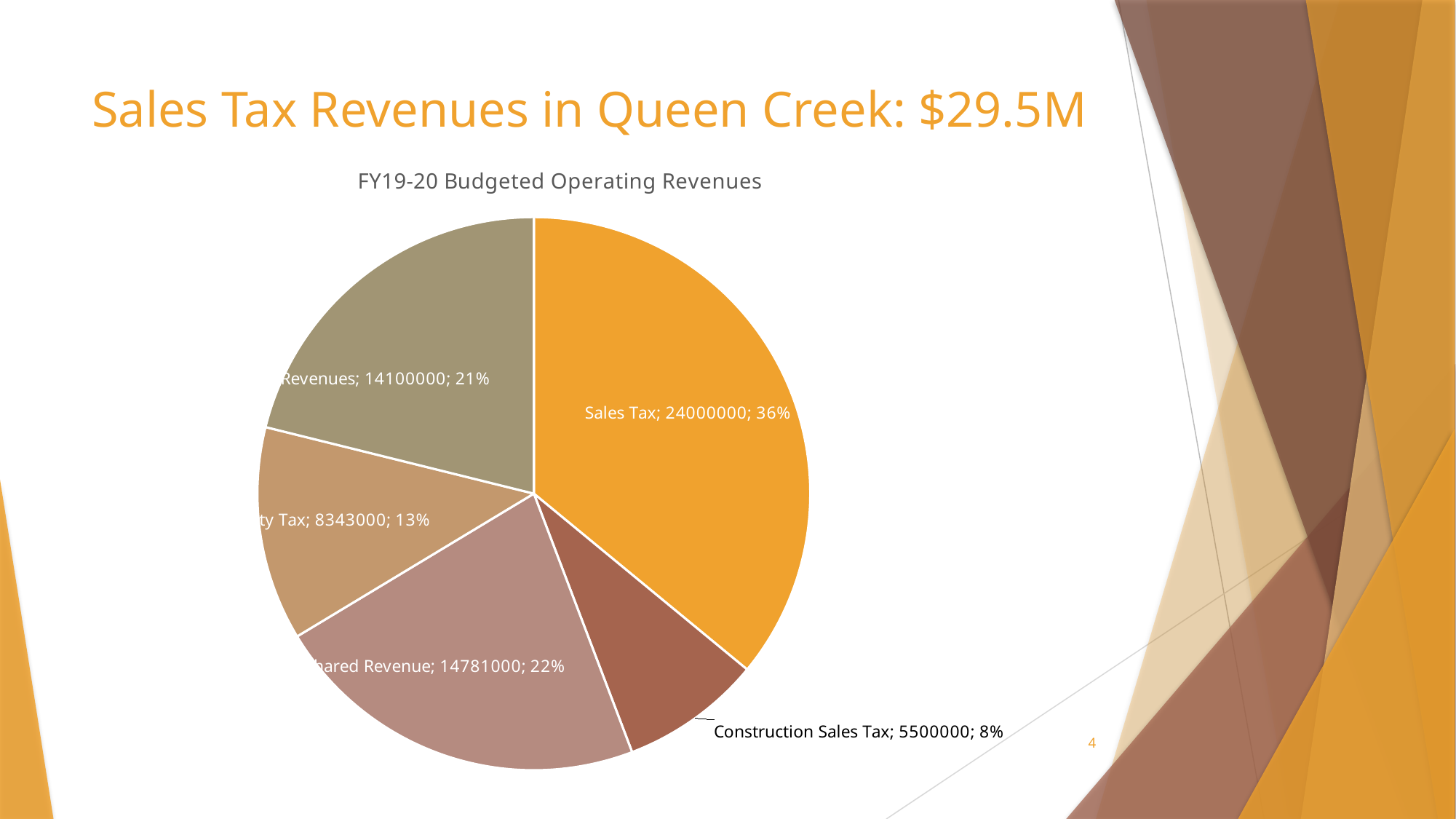
How many slices does the pie chart have? 5 Which slice is the largest in the pie chart? Sales Tax What colour is the Sales Tax slice? Orange Which slice is the smallest in the pie chart? Construction Sales Tax What is the difference between the Sales Tax value and the Construction Sales Tax value? 18500000 What is the title of the chart? FY19-20 Budgeted Operating Revenues What type of chart is shown on the slide? Pie chart What is the value shown for Sales Tax? 24000000 What share of the pie does Sales Tax represent? 36% What is the value shown for Construction Sales Tax? 5500000 Which is larger, Sales Tax or Construction Sales Tax? Sales Tax What share of the pie does Construction Sales Tax represent? 8%